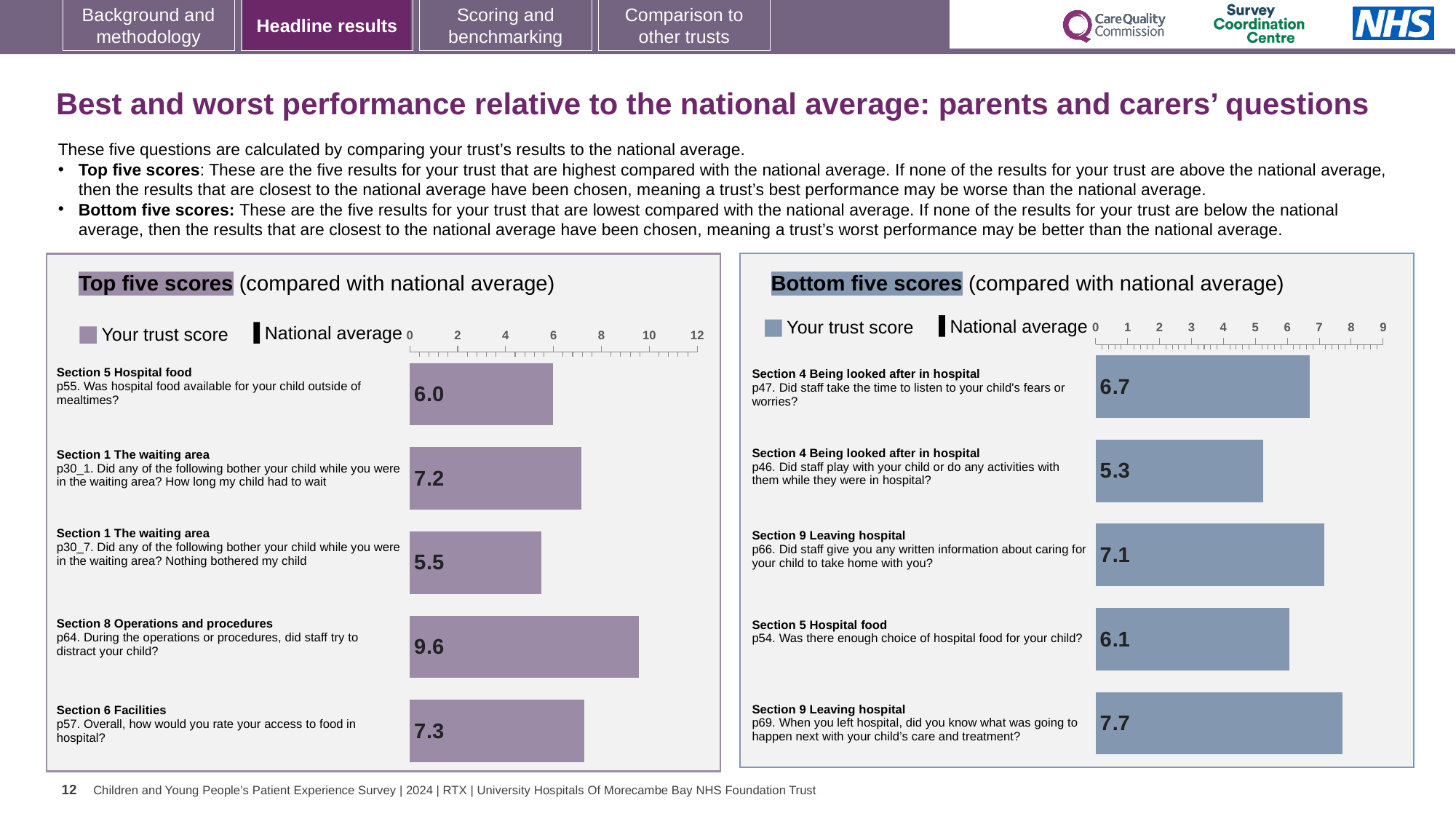
In the Top five scores chart, what is the trust score for p64 (During the operations or procedures, did staff try to distract your child?)? 9.6 In the Top five scores chart, what is the trust score for p55 (Was hospital food available for your child outside of mealtimes?)? 6.0 In the Top five scores chart, which question has the lowest trust score? p30_7. Did any of the following bother your child while you were in the waiting area? Nothing bothered my child In the Bottom five scores chart, what is the trust score for p46 (Did staff play with your child or do any activities with them while they were in hospital?)? 5.3 How many questions are plotted in the Bottom five scores chart? 5 In the Bottom five scores chart, which question has the lowest trust score? p46. Did staff play with your child or do any activities with them while they were in hospital? In the Top five scores chart, which question has the highest trust score? p64. During the operations or procedures, did staff try to distract your child? In the Top five scores chart, what is the difference between the trust scores for p64 and p30_7? 4.1 In the Bottom five scores chart, which has the larger trust score: p47 or p54? p47 What type of chart is the Top five scores chart? Bar chart In the Bottom five scores chart, which question has the highest trust score? p69. When you left hospital, did you know what was going to happen next with your child's care and treatment? In the Bottom five scores chart, what is the trust score for p69 (When you left hospital, did you know what was going to happen next with your child's care and treatment?)? 7.7